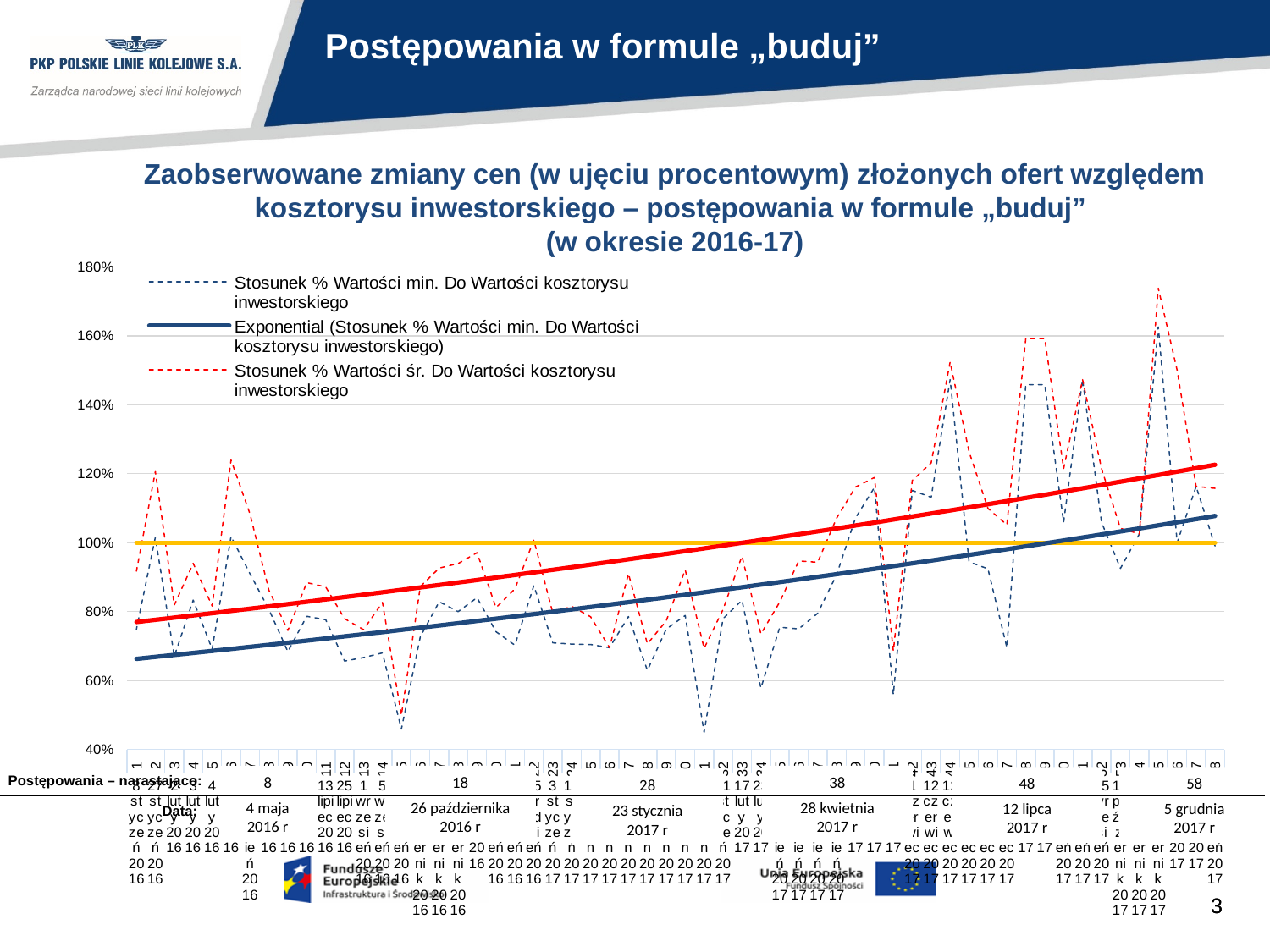
Is the value of the solid blue exponential trend line at the left end of the chart greater or less than 80%? less Is the value of the solid red exponential trend line at the left end of the chart greater or less than 80%? less Which of the two exponential trend lines is higher at the right end of the chart, the red one or the blue one? the red one What is the lowest value shown on the vertical axis of the chart? 40% What kind of chart is shown on the slide? line chart Does the solid blue exponential trend line rise or fall from left to right along the x axis? rises At which percentage level does the horizontal yellow line run across the chart? 100% Does the solid red exponential trend line rise or fall from left to right along the x axis? rises Is the highest peak of the dashed red series greater or less than 160%? greater What is the highest value shown on the vertical axis of the chart? 180% How many series does the chart legend list? 3